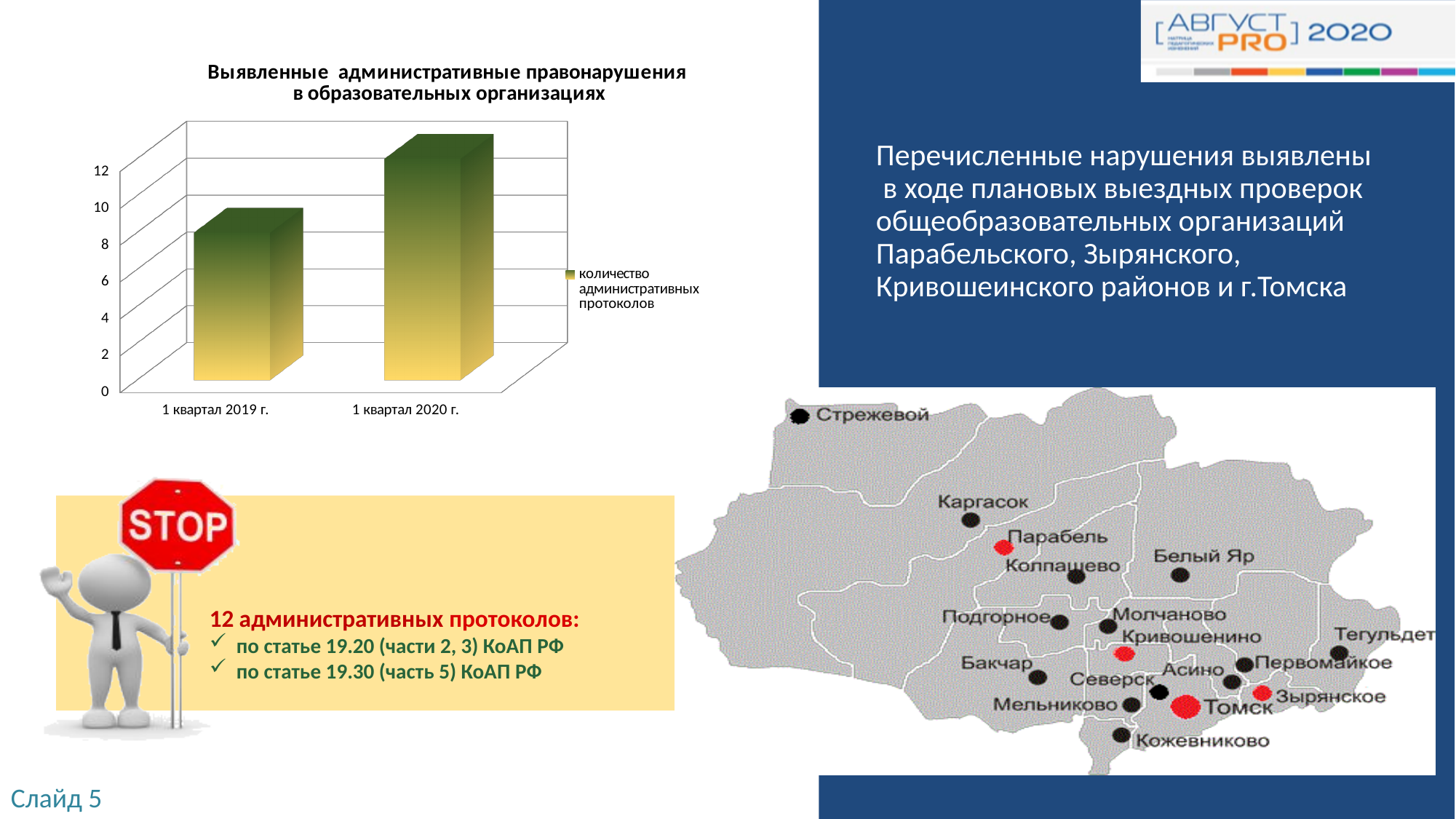
Do the values rise or fall from 1 квартал 2019 г. to 1 квартал 2020 г.? rise What series name is shown in the chart legend? количество административных протоколов What kind of chart is shown on the slide? bar chart How many categories are plotted on the x axis of the chart? 2 How many series does the chart legend list? 1 Is the value for 1 квартал 2019 г. greater or less than 6? greater Which is larger: the value for 1 квартал 2019 г. or for 1 квартал 2020 г.? 1 квартал 2020 г. What is the title of the chart? Выявленные административные правонарушения в образовательных организациях Is the value for 1 квартал 2020 г. greater or less than 10? greater Is the value for 1 квартал 2019 г. greater or less than 10? less Which category has the lowest value in the chart? 1 квартал 2019 г. Which category has the highest value in the chart? 1 квартал 2020 г.